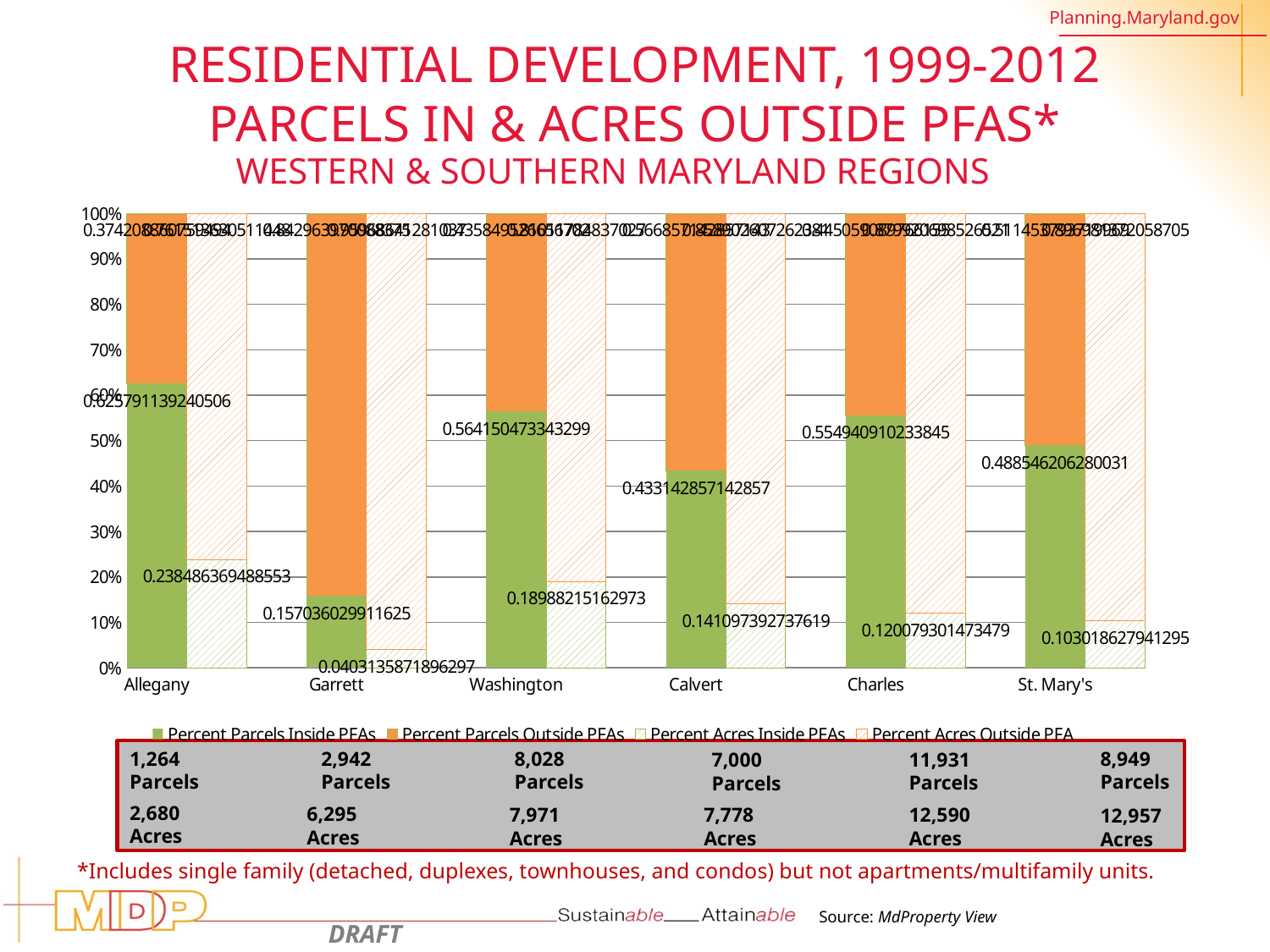
What is the Percent Acres Inside PFAs value for Charles? 0.120079301473479 What is the Percent Parcels Inside PFAs value for Allegany? 0.625791139240506 How many series does the chart legend list? 4 Which county has the highest Percent Parcels Inside PFAs? Allegany Which has the larger Percent Parcels Inside PFAs value, Calvert or St. Mary's? St. Mary's Is the Percent Parcels Inside PFAs value for Calvert greater or less than 50%? less Which county has the lowest Percent Parcels Inside PFAs? Garrett What is the Percent Acres Inside PFAs value for Garrett? 0.0403135871896297 Which county has the lowest Percent Acres Inside PFAs? Garrett What kind of chart is shown on the slide? Stacked bar chart Which region does the chart's subtitle say the data covers? Western & Southern Maryland Regions How many counties are shown along the x axis of the chart? 6